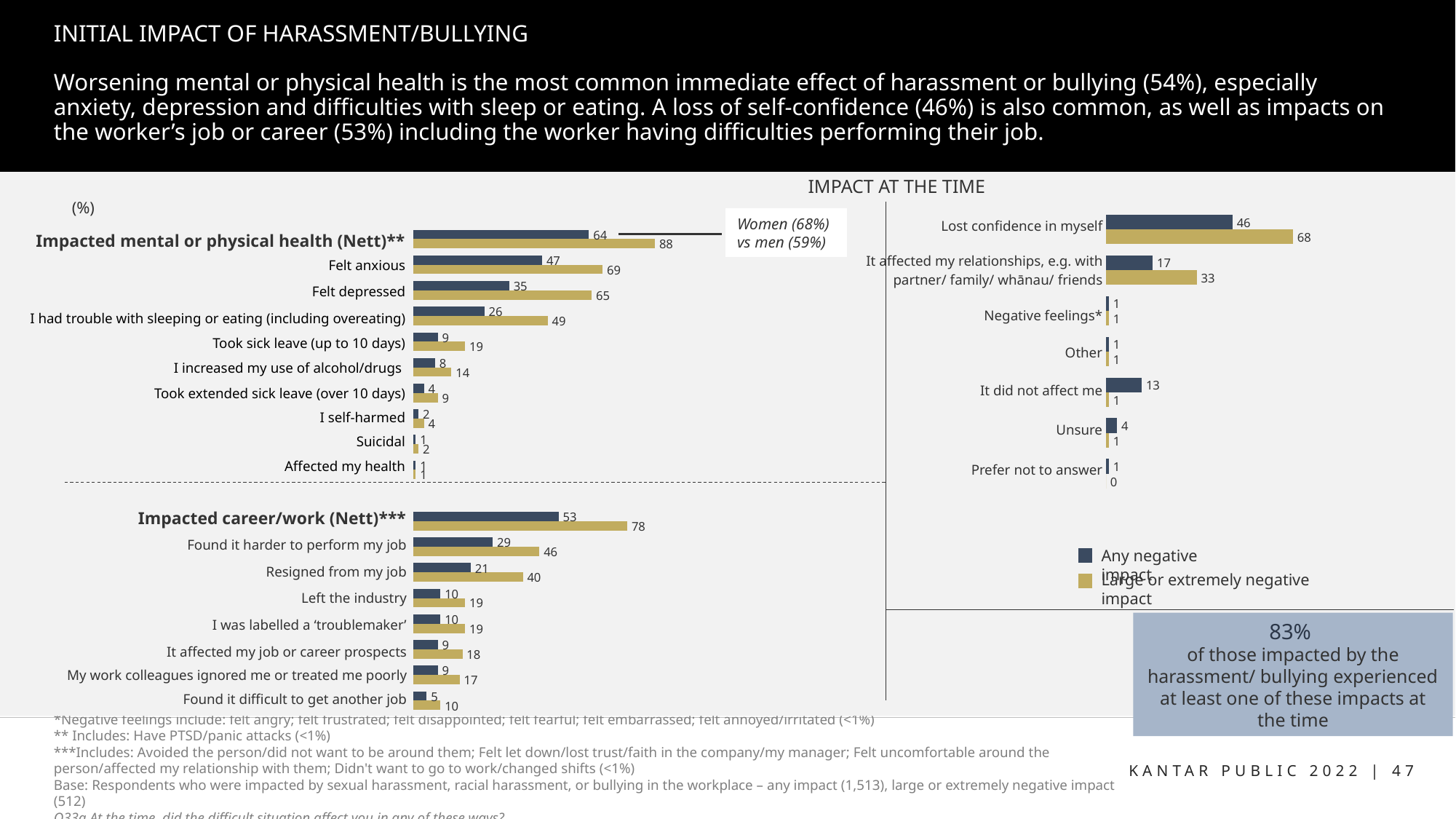
How many series does the legend of the 'Impact at the time' chart list? 2 In the left panel of the 'Impact at the time' chart, what is the difference between the 'Large or extremely negative impact' and 'Any negative impact' values for 'Impacted career/work (Nett)***'? 25 In the left panel of the 'Impact at the time' chart, which category has the highest 'Large or extremely negative impact' value? Impacted mental or physical health (Nett)** What kind of chart is the 'Impact at the time' chart? Bar chart In the right panel of the 'Impact at the time' chart, which is larger for 'It did not affect me': the 'Any negative impact' value or the 'Large or extremely negative impact' value? Any negative impact In the left panel of the 'Impact at the time' chart, what is the 'Any negative impact' value for 'Resigned from my job'? 21 In the 'Impact at the time' chart, which colour represents the 'Large or extremely negative impact' series? Gold In the right panel of the 'Impact at the time' chart, which category has the lowest 'Large or extremely negative impact' value? Prefer not to answer How many categories are shown in the right panel of the 'Impact at the time' chart? 7 In the right panel of the 'Impact at the time' chart, what is the 'Large or extremely negative impact' value for 'Lost confidence in myself'? 68 In the left panel of the 'Impact at the time' chart, what is the 'Large or extremely negative impact' value for 'Felt depressed'? 65 In the left panel of the 'Impact at the time' chart, what is the 'Any negative impact' value for 'Felt anxious'? 47